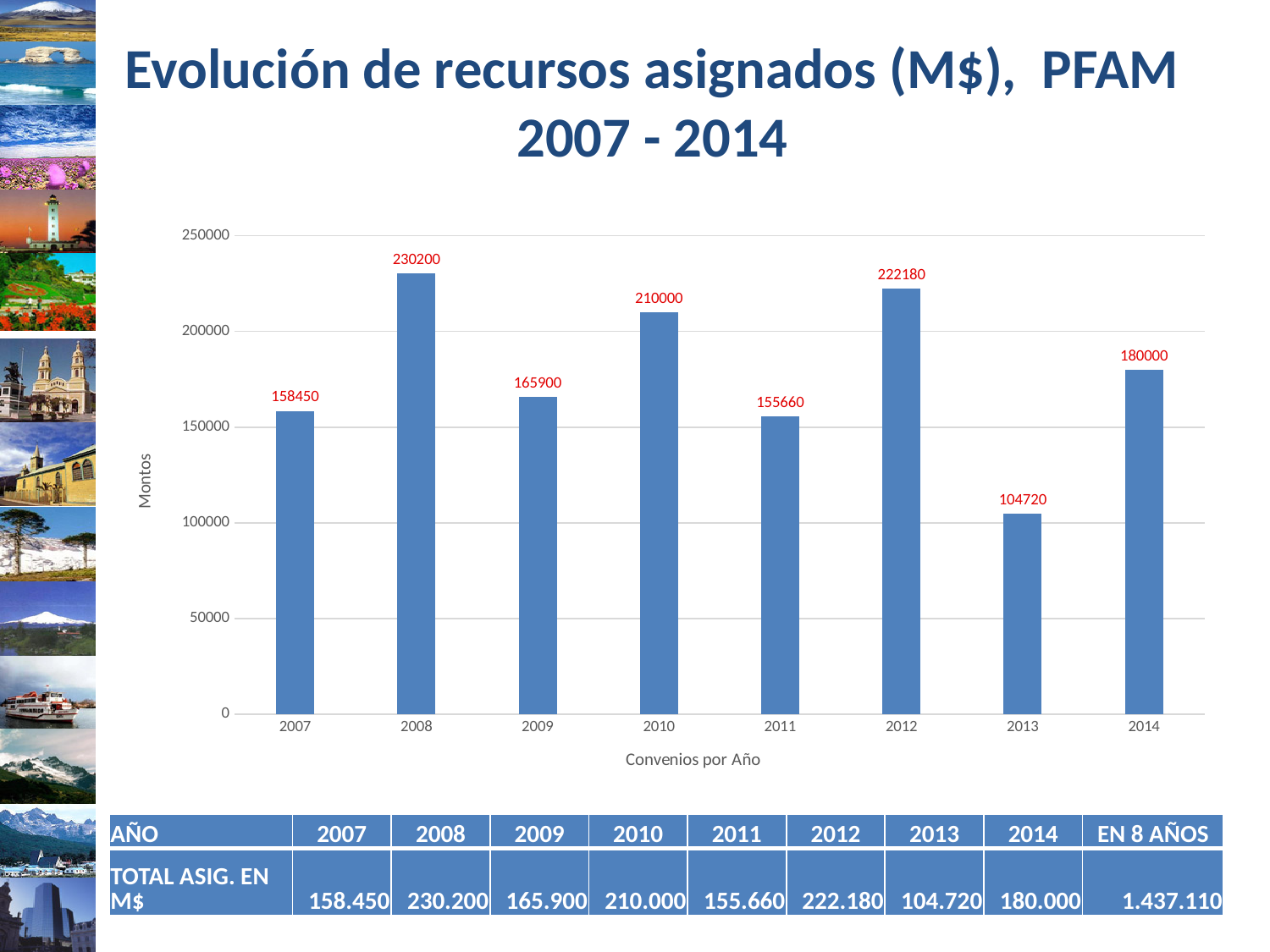
What is the value for 2008? 230200 What is the difference between the values for 2012 and 2010? 12180 Which year has the lowest value? 2013 What is the difference between the values for 2008 and 2013? 125480 Is the value for 2014 greater or less than 150000? greater How many years are shown on the x axis? 8 Which year has the highest value? 2008 What is the value for 2011? 155660 What is the label of the y axis? Montos What kind of chart is shown? bar chart What is the value for 2013? 104720 Which is larger, the value for 2009 or the value for 2011? 2009